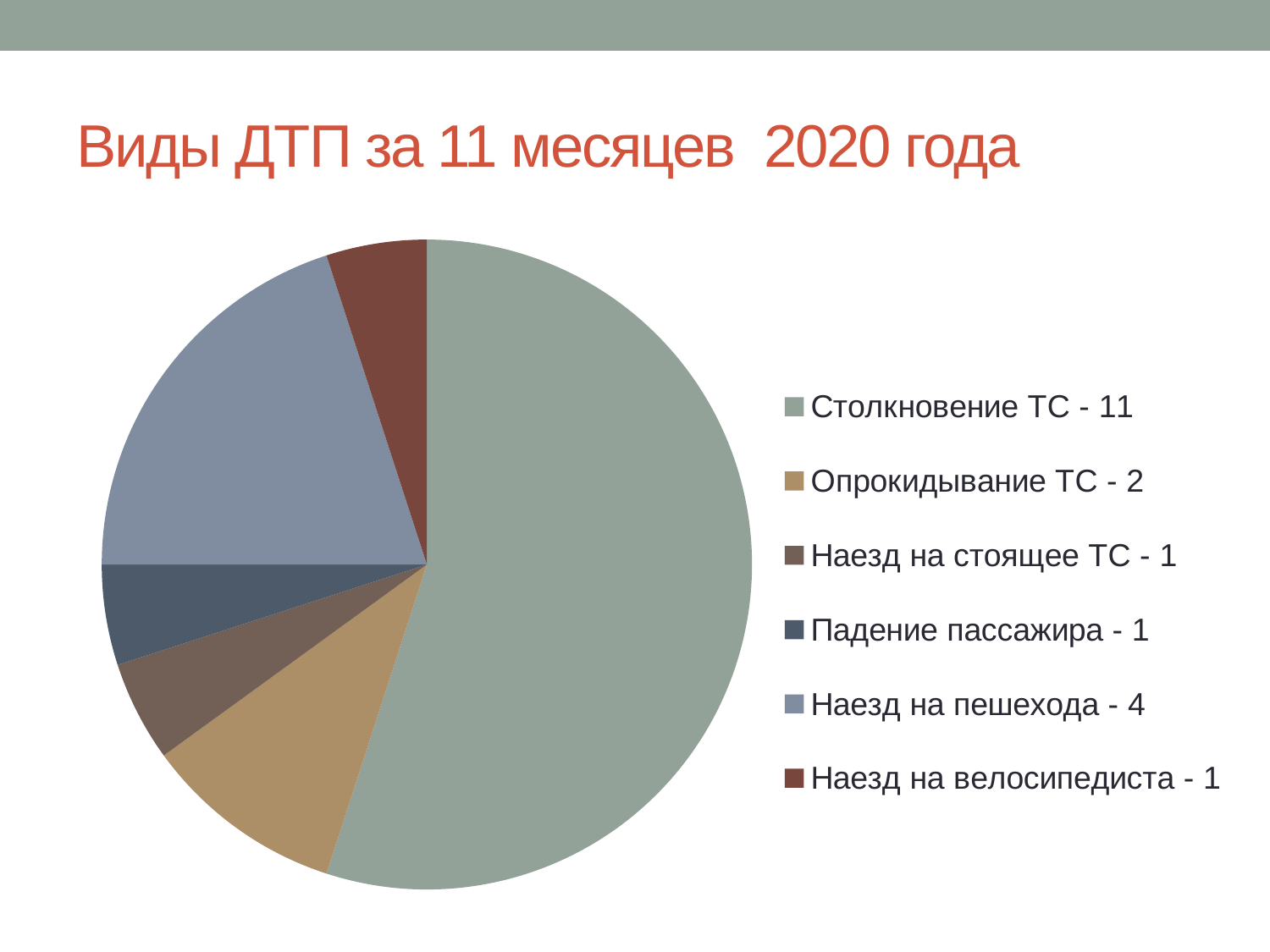
What kind of chart is shown on the slide? Pie chart What is the value for Столкновение ТС? 11 What share of the pie does Столкновение ТС represent? 55% What is the value for Наезд на пешехода? 4 How many categories does the pie chart have? 6 What is the total of all values shown in the pie chart? 20 Which is larger, the value for Наезд на пешехода or the value for Опрокидывание ТС? Наезд на пешехода What is the value for Опрокидывание ТС? 2 What is the difference between the values for Столкновение ТС and Наезд на пешехода? 7 Which category has the largest slice of the pie? Столкновение ТС What is the value for Падение пассажира? 1 What is the title of the chart on the slide? Виды ДТП за 11 месяцев 2020 года